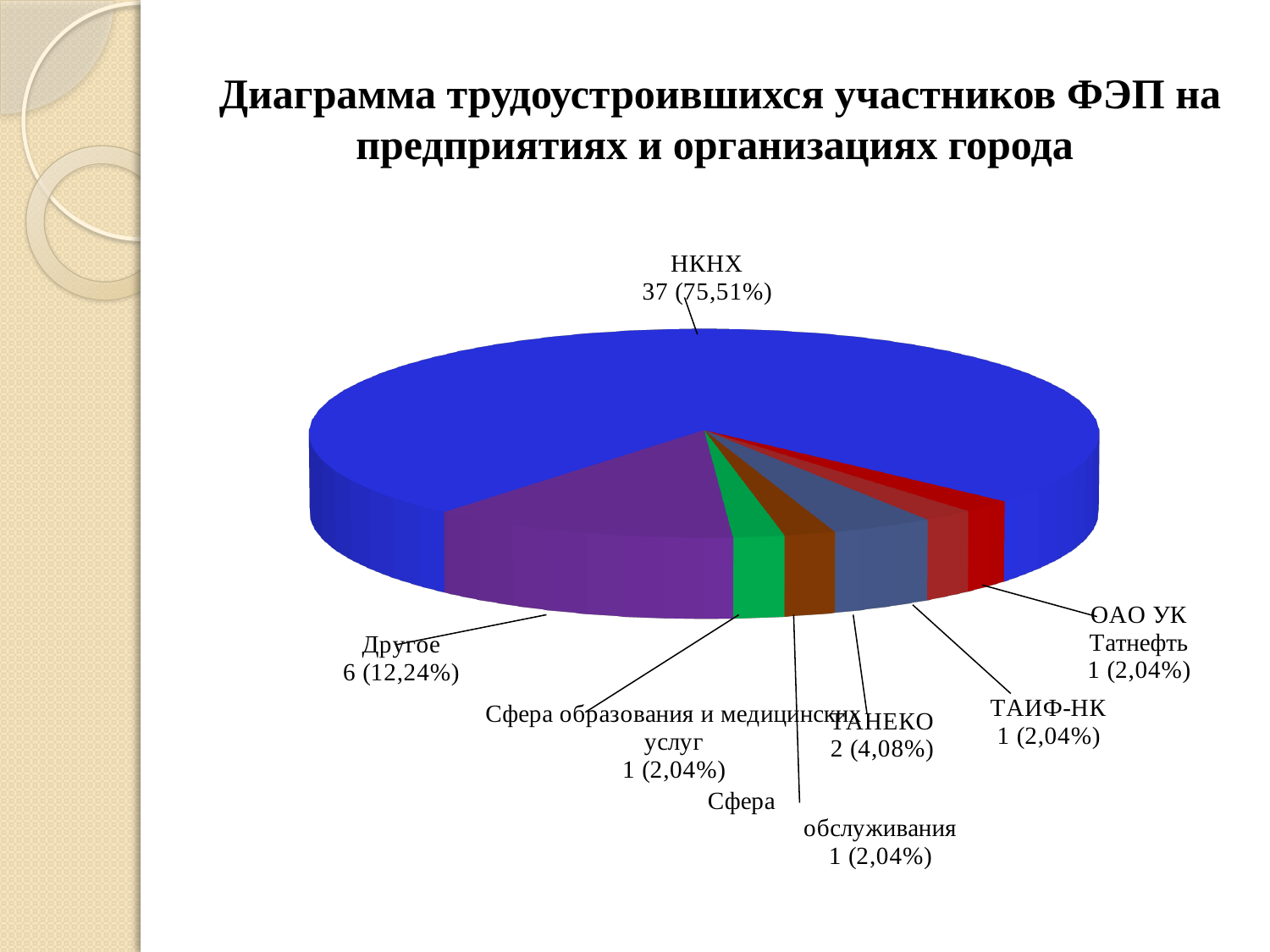
What share of the pie does ОАО УК Татнефть represent? 2,04% What share of the pie does НКНХ represent? 75,51% What is the title of the chart on the slide? Диаграмма трудоустроившихся участников ФЭП на предприятиях и организациях города What kind of chart is shown on the slide? pie chart How many participants fall into the Другое category? 6 How many slices does the pie chart have? 7 What is the total number of participants across all slices of the pie? 49 How many participants were employed at НКНХ? 37 Which category has the largest slice of the pie? НКНХ Which is larger, the value for ТАНЕКО or the value for ТАИФ-НК? ТАНЕКО What share of the pie does ТАНЕКО represent? 4,08% What is the difference between the number of participants at НКНХ and in the Другое category? 31